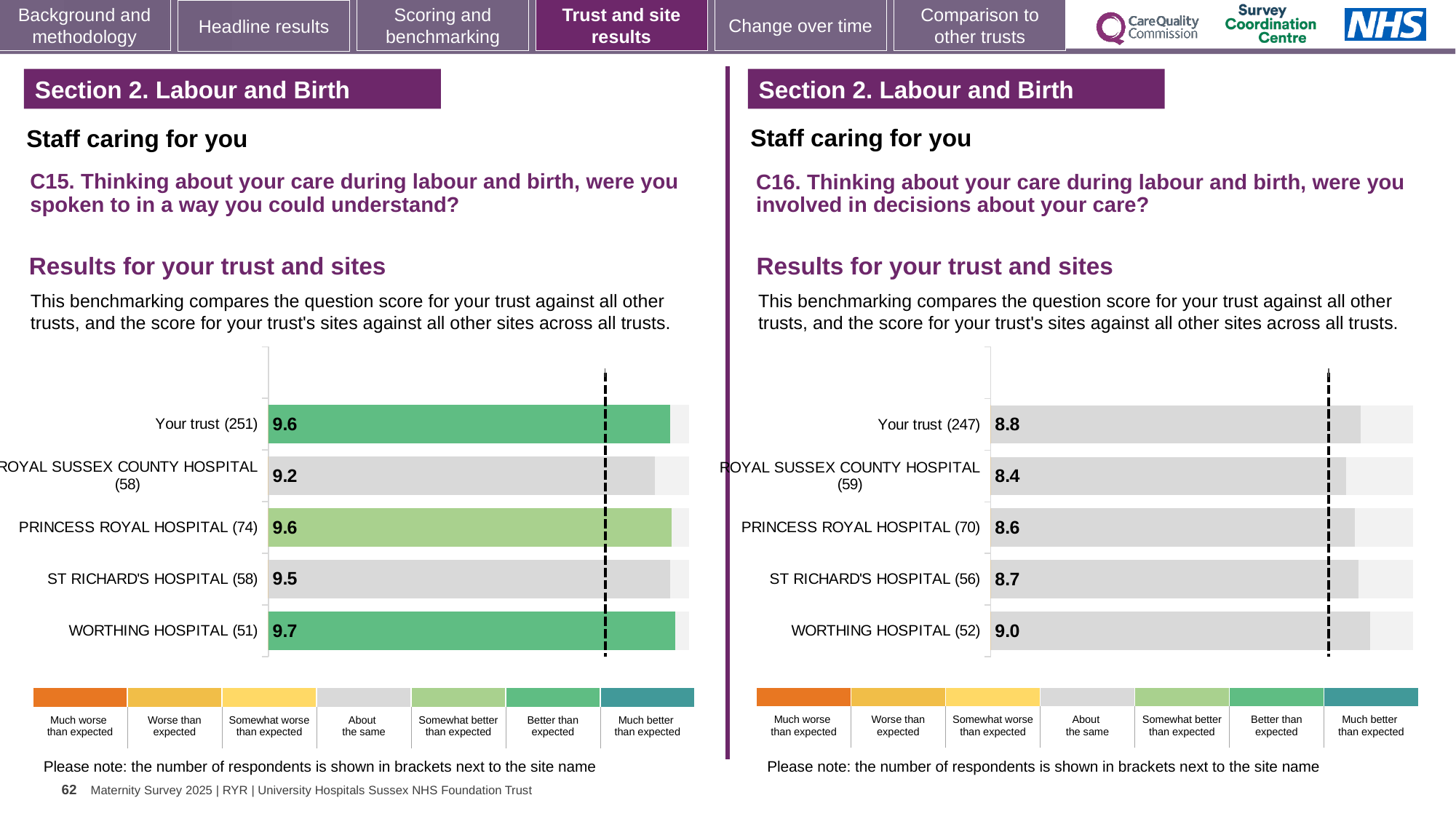
In the C15 chart on the left, what is the score for Your trust? 9.6 In the C15 chart on the left, which site has the lowest score? Royal Sussex County Hospital In the C16 chart on the right, what is the score for St Richard's Hospital? 8.7 In the C16 chart on the right, what is the score for Your trust? 8.8 In the C16 chart on the right, which site has the highest score? Worthing Hospital In the C16 chart on the right, which site has the lowest score? Royal Sussex County Hospital How many bars are plotted in the C16 chart on the right? 5 In the C15 chart on the left, which site has the highest score? Worthing Hospital In the C15 chart on the left, what is the score for Royal Sussex County Hospital? 9.2 In the C16 chart on the right, which has the larger score, Princess Royal Hospital or Worthing Hospital? Worthing Hospital In the C15 chart on the left, what is the difference between the scores for Worthing Hospital and Royal Sussex County Hospital? 0.5 What type of chart is used in the C15 chart on the left? Bar chart